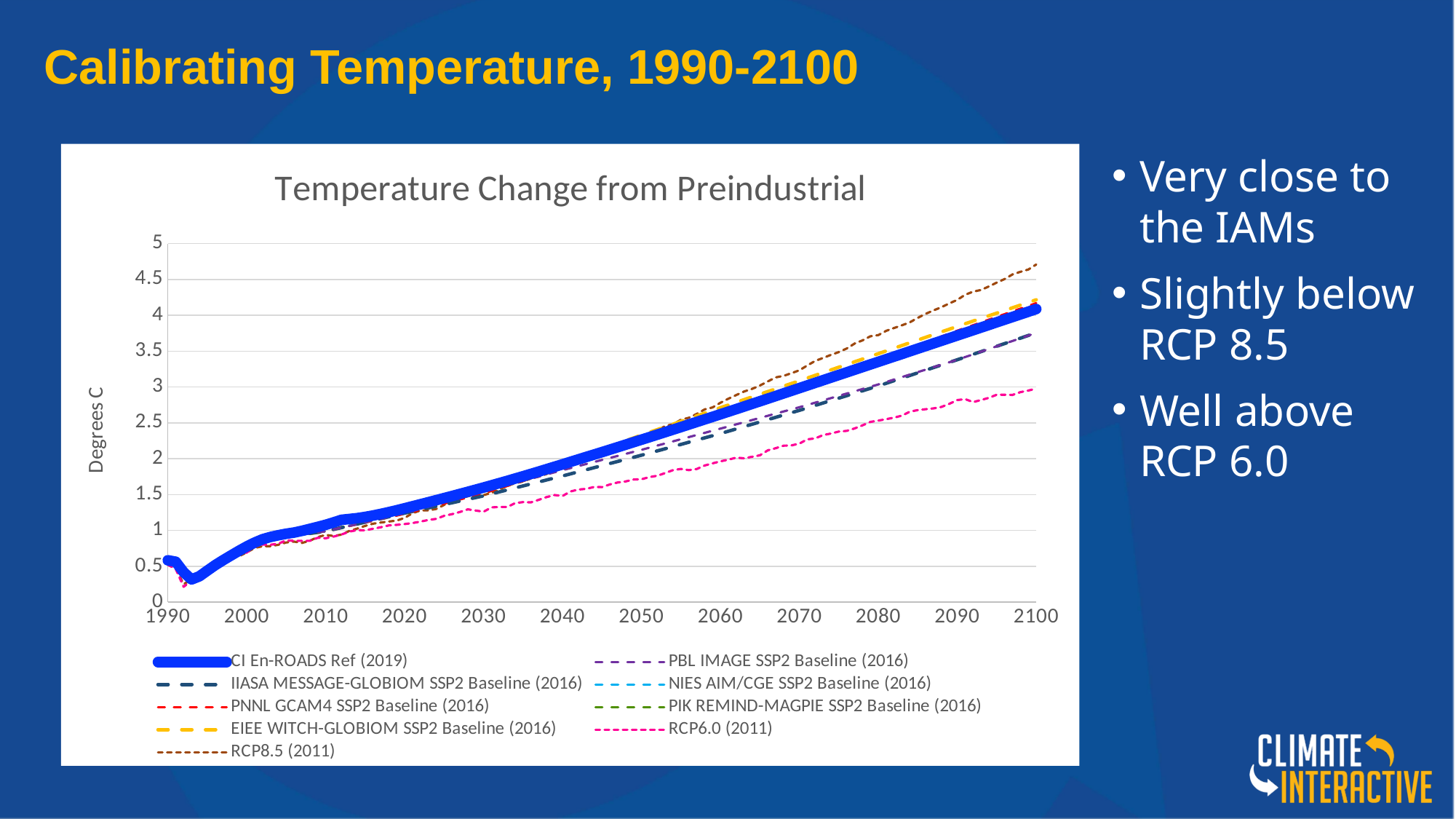
Which series has the highest value at 2100? RCP8.5 (2011) Which series has the lowest value at 2100? RCP6.0 (2011) What kind of chart is shown on the slide? line chart Do the values for CI En-ROADS Ref (2019) rise or fall from 2000 to 2100? rise What is the title of the chart? Temperature Change from Preindustrial Is the value for CI En-ROADS Ref (2019) at 2100 greater or less than 3.5? greater Is the value for RCP8.5 (2011) at 2100 greater or less than 4.5? greater Is the value for RCP6.0 (2011) at 2100 greater or less than 3.5? less How many series does the legend list? 9 What is the label on the vertical axis? Degrees C How many year labels are shown on the horizontal axis? 12 At 2100, which is larger: RCP8.5 (2011) or RCP6.0 (2011)? RCP8.5 (2011)